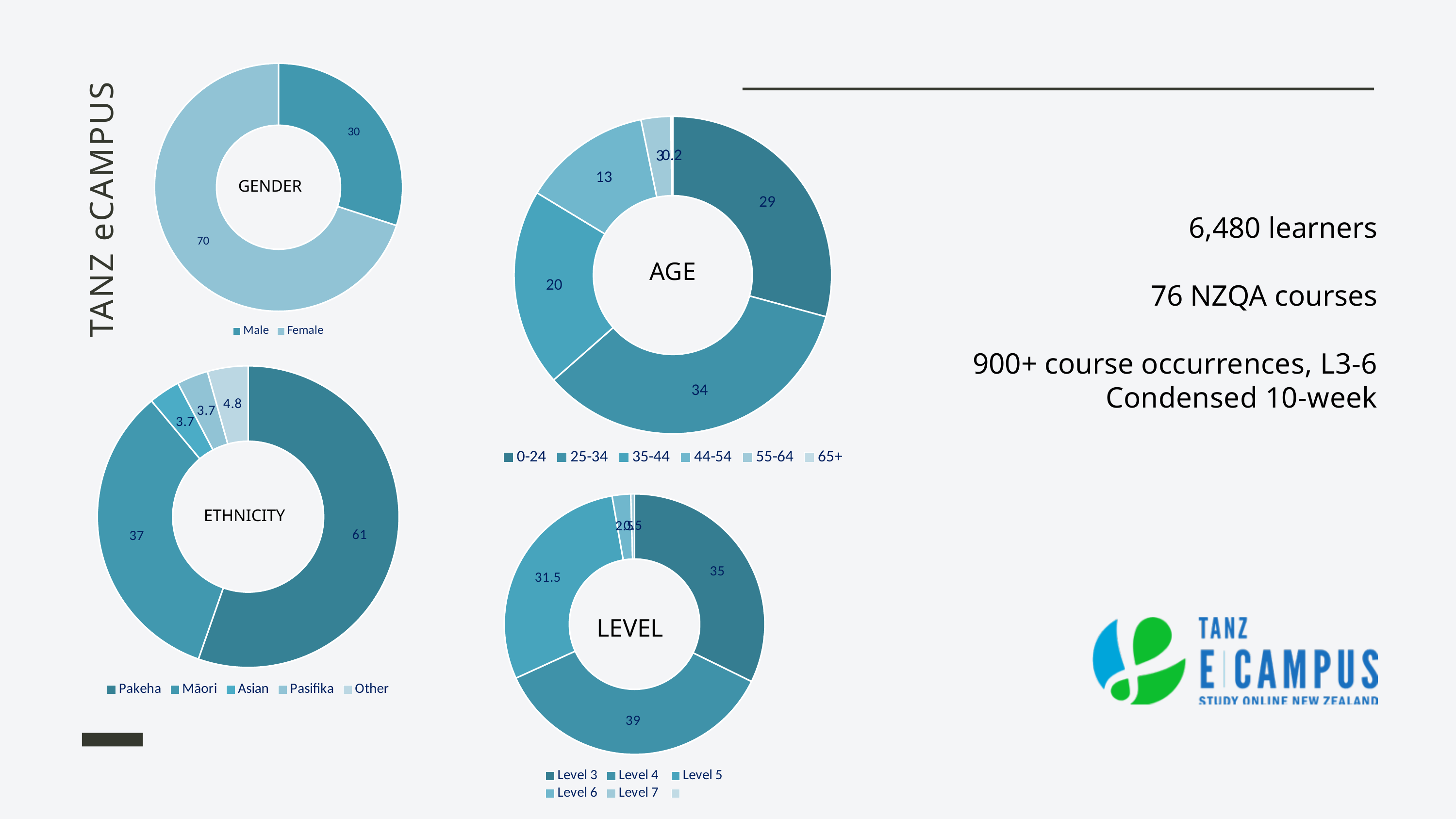
In the AGE chart, what is the value for the 35-44 group? 20 In the AGE chart, which age group has the largest value? 25-34 In the GENDER chart, what is the value for Female? 70 In the ETHNICITY chart, which category has the largest value? Pakeha In the GENDER chart, what is the difference between the Female and Male values? 40 In the AGE chart, how many age groups does the legend list? 6 In the AGE chart, what is the value for the 44-54 group? 13 In the GENDER chart, what is the value for Male? 30 In the LEVEL chart, which level has the largest value? Level 4 In the ETHNICITY chart, what is the value for Pakeha? 61 In the LEVEL chart, what is the value for Level 5? 31.5 In the ETHNICITY chart, what is the difference between the Pakeha and Māori values? 24